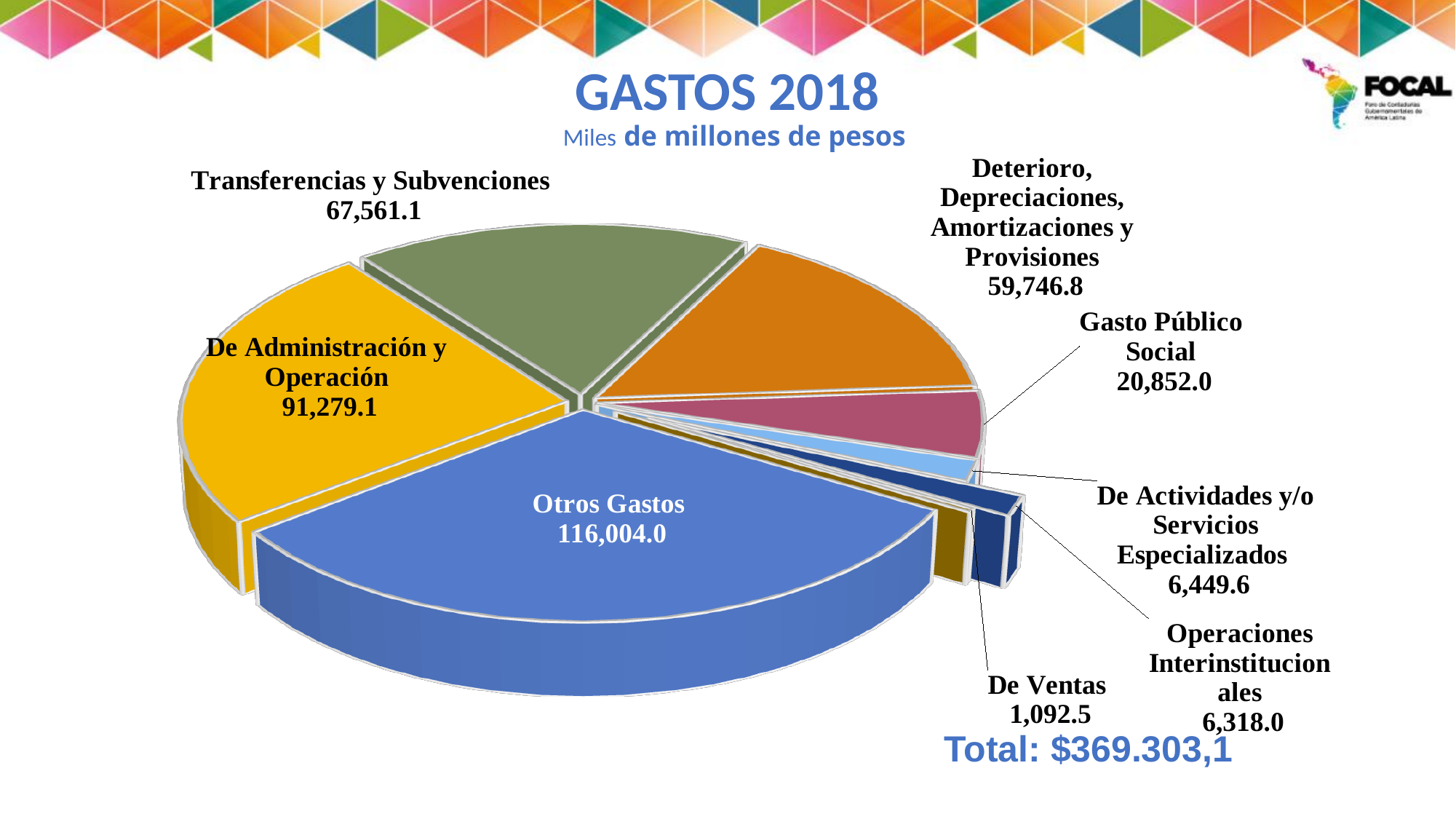
How many categories are shown in the pie chart? 8 What is the difference between Otros Gastos and De Administración y Operación? 24,724.9 Which category has the largest slice of the pie? Otros Gastos What is the difference between Transferencias y Subvenciones and Deterioro, Depreciaciones, Amortizaciones y Provisiones? 7,814.3 What is the value for Otros Gastos in the GASTOS 2018 pie chart? 116,004.0 What total is printed on the slide for the 2018 expenses? $369.303,1 Which category has the smallest slice of the pie? De Ventas What is the value for Gasto Público Social? 20,852.0 What is the value for De Ventas? 1,092.5 Which is larger, De Actividades y/o Servicios Especializados or Operaciones Interinstitucionales? De Actividades y/o Servicios Especializados What is the value for Deterioro, Depreciaciones, Amortizaciones y Provisiones? 59,746.8 What kind of chart is shown on the slide? Pie chart